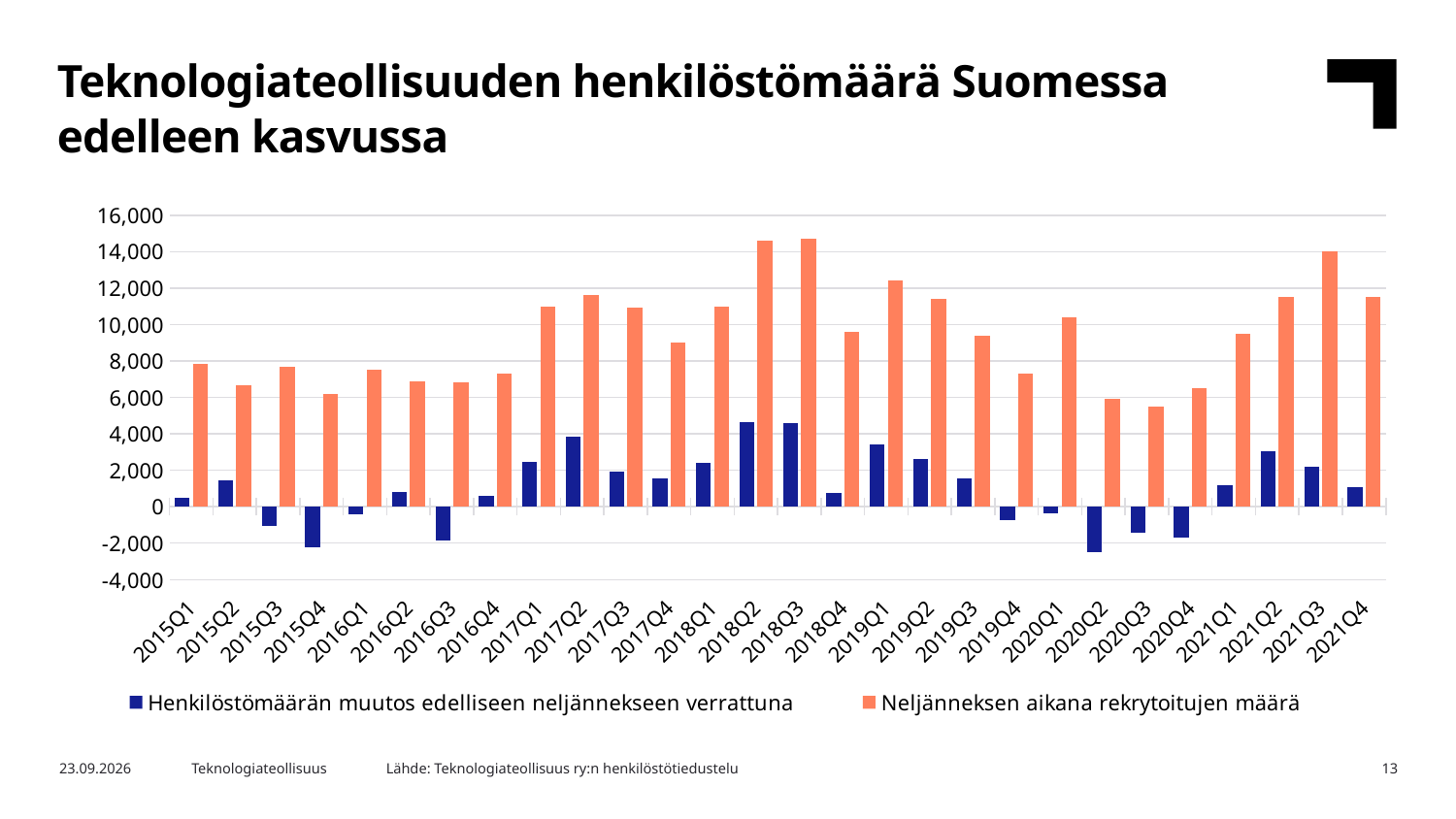
Is the value of 'Neljänneksen aikana rekrytoitujen määrä' for 2021Q3 greater or less than 12,000? greater How many quarters are shown on the x axis? 28 Which quarter has the larger value of 'Henkilöstömäärän muutos edelliseen neljännekseen verrattuna', 2019Q1 or 2019Q2? 2019Q1 Is the value of 'Neljänneksen aikana rekrytoitujen määrä' for 2020Q3 greater or less than 6,000? less Which colour represents 'Neljänneksen aikana rekrytoitujen määrä' in the chart? Orange Is the value of 'Henkilöstömäärän muutos edelliseen neljännekseen verrattuna' for 2017Q2 greater or less than 2,000? greater Does the value of 'Neljänneksen aikana rekrytoitujen määrä' rise or fall from 2020Q3 to 2021Q3? rise What kind of chart is shown on the slide? Bar chart How many series does the legend list? 2 Which quarter has the larger value of 'Neljänneksen aikana rekrytoitujen määrä', 2021Q3 or 2021Q4? 2021Q3